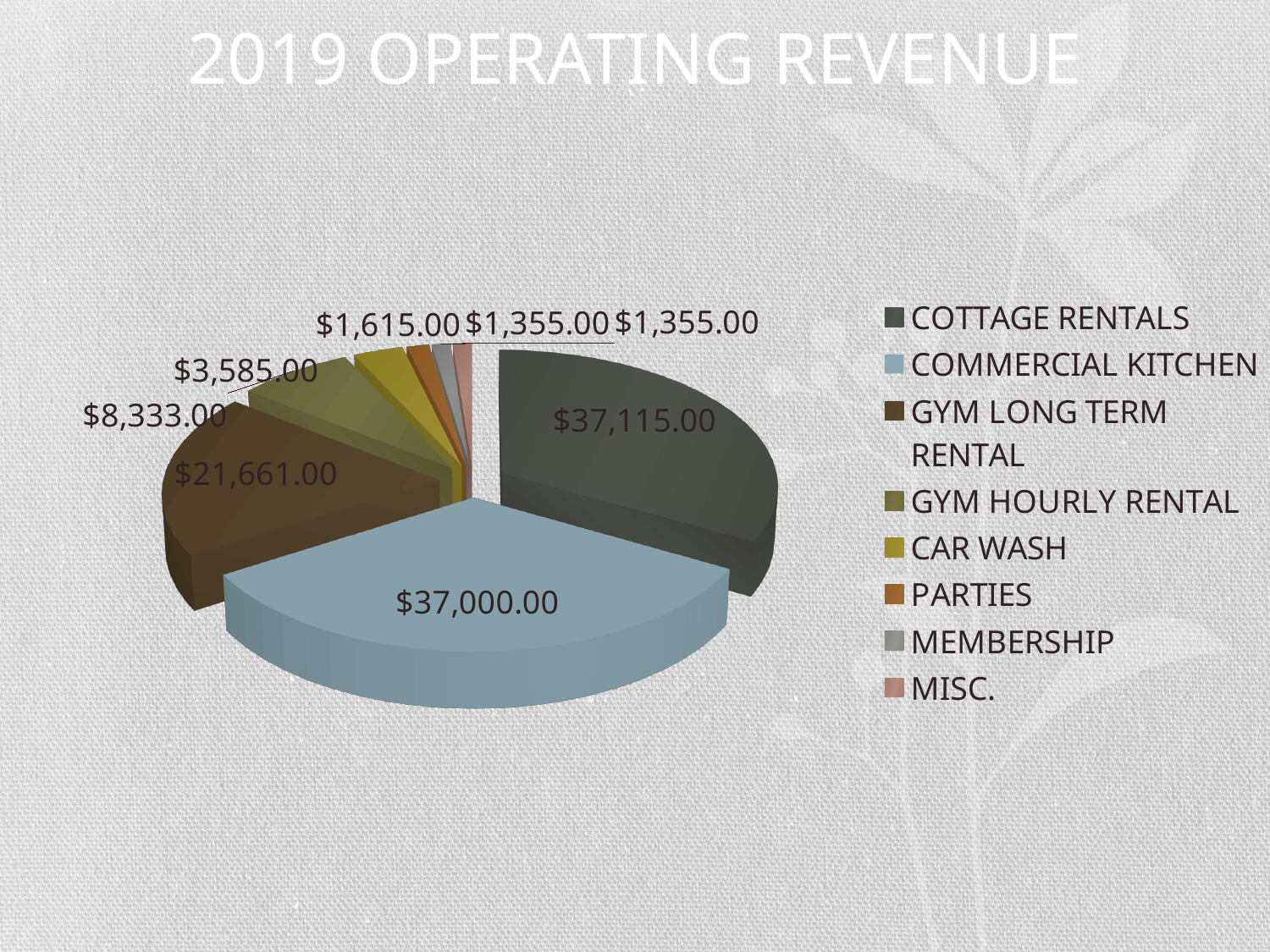
What is the difference between GYM LONG TERM RENTAL and GYM HOURLY RENTAL? $13,328.00 How many categories does the pie chart show? 8 What is the value for GYM LONG TERM RENTAL? $21,661.00 What kind of chart is shown on the slide? Pie chart What is the value for COMMERCIAL KITCHEN? $37,000.00 What is the value for PARTIES? $1,615.00 Which category has the highest revenue? COTTAGE RENTALS What is the value for CAR WASH? $3,585.00 Which is larger, CAR WASH or PARTIES? CAR WASH What is the title of the chart? 2019 OPERATING REVENUE What is the value for COTTAGE RENTALS? $37,115.00 What is the value for GYM HOURLY RENTAL? $8,333.00